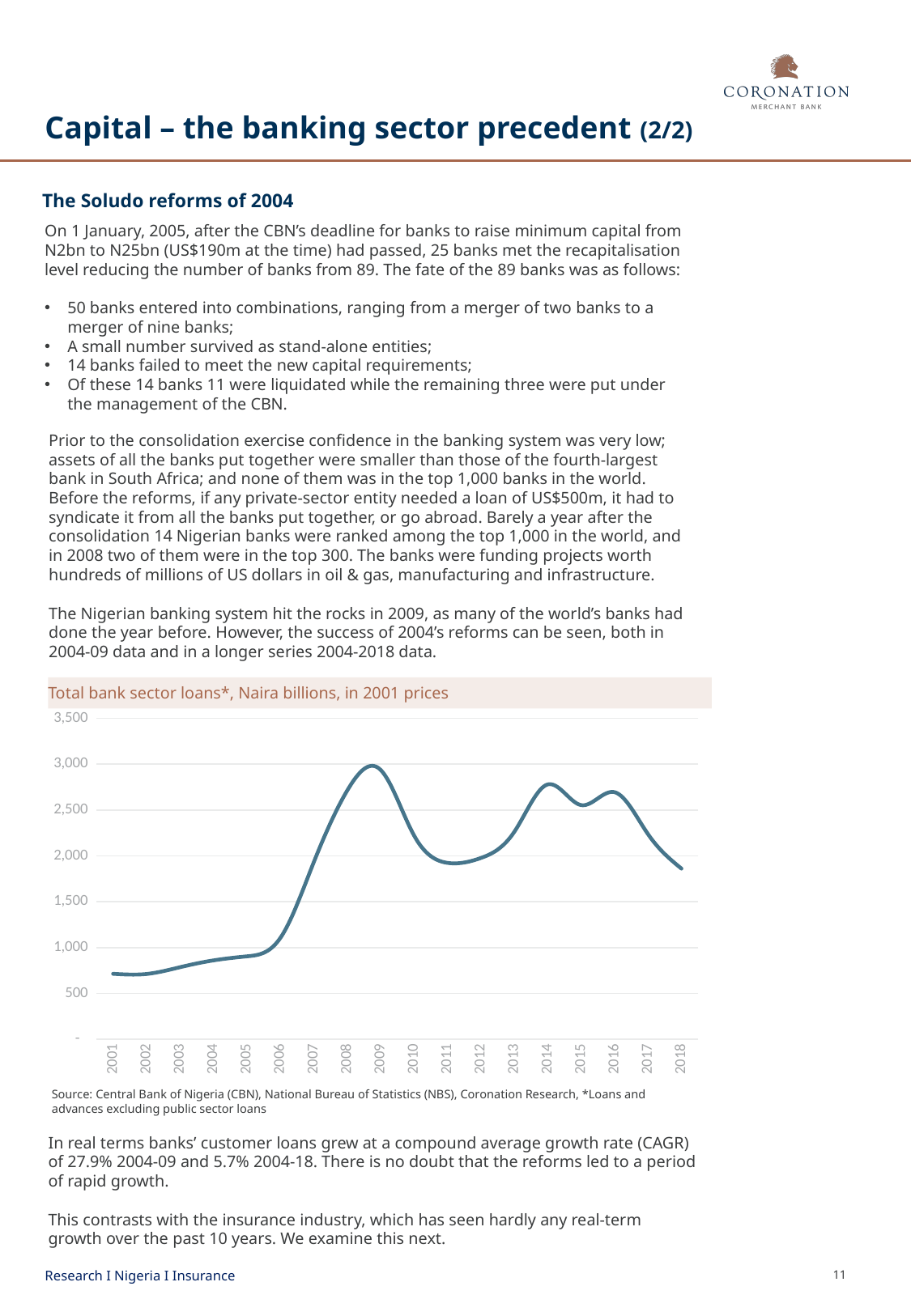
Is the value for 2018 greater or less than 2,000? less Is the value for 2011 greater or less than 2,000? less Is the value for 2014 greater or less than 2,500? greater How many years are plotted along the x axis of the chart? 18 Which is larger, the value for 2009 or the value for 2014? 2009 What is the title of the chart? Total bank sector loans*, Naira billions, in 2001 prices What kind of chart is shown on the slide? Line chart Which year has the highest value of total bank sector loans? 2009 Do total bank sector loans rise or fall between 2005 and 2009? Rise Do total bank sector loans rise or fall between 2016 and 2018? Fall